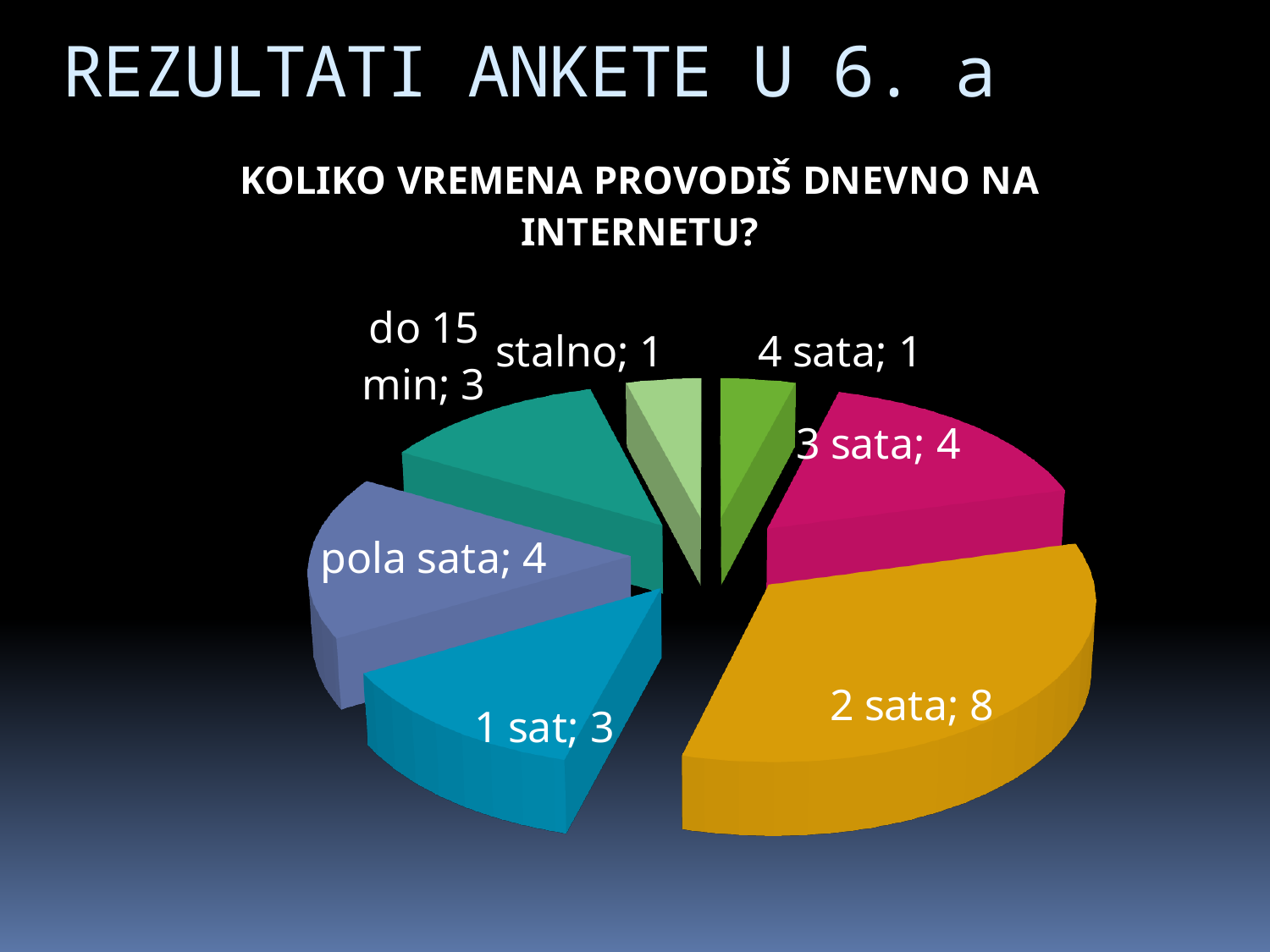
Which is larger, the value for "1 sat" or the value for "pola sata"? pola sata What is the total of all the values in the pie chart? 24 How many categories (slices) does the pie chart have? 7 What is the difference between the values for "2 sata" and "3 sata"? 4 What is the title of the chart? KOLIKO VREMENA PROVODIŠ DNEVNO NA INTERNETU? What kind of chart is shown on the slide? pie chart Which categories have the lowest value? stalno and 4 sata What is the value for "pola sata"? 4 Which category has the highest value? 2 sata What is the value for "do 15 min"? 3 What is the value for "2 sata"? 8 What is the value for "stalno"? 1